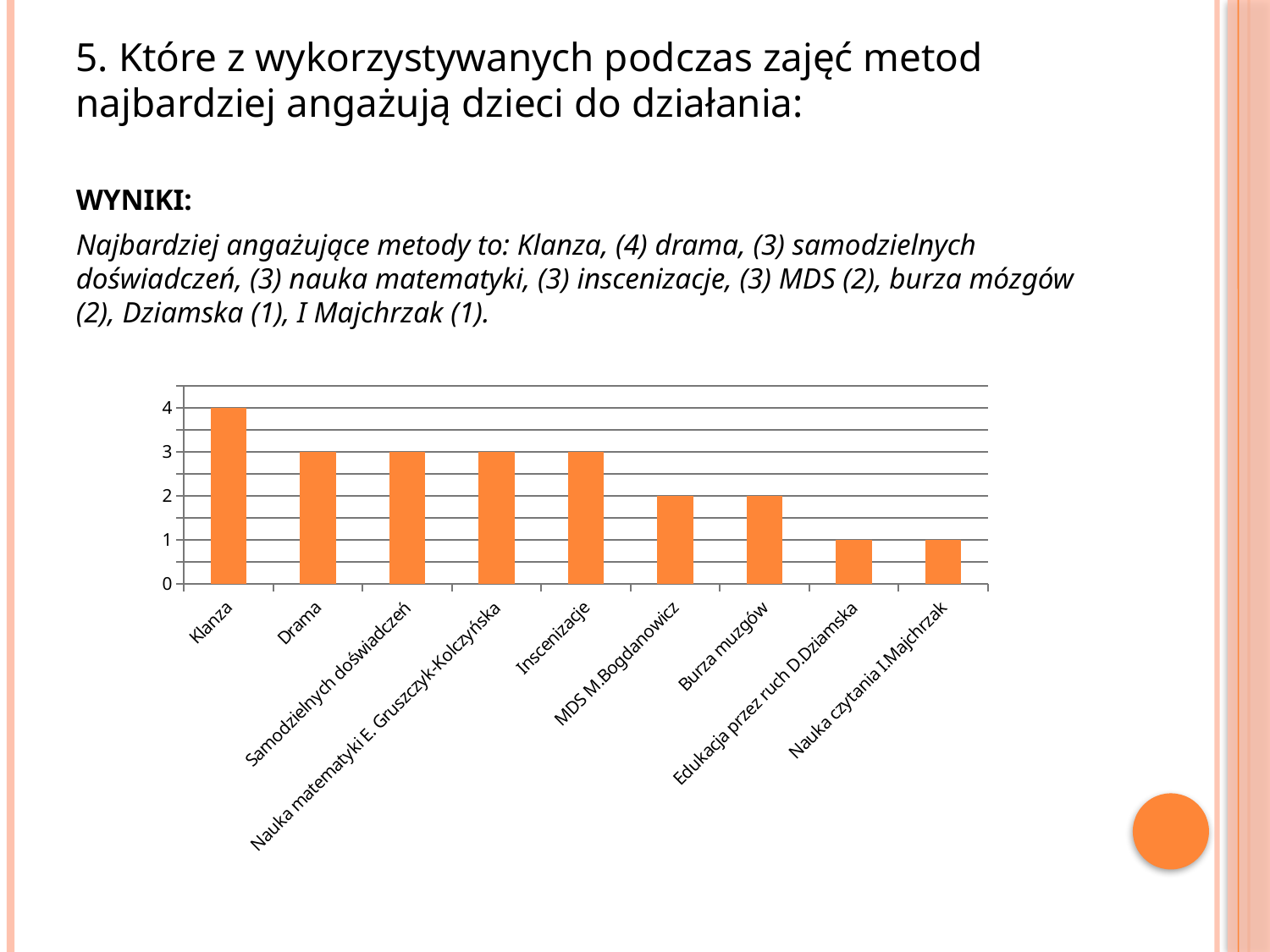
What is the value for Drama? 3 What colour are the bars in the chart? orange What kind of chart is shown on the slide? bar chart Do the values generally rise or fall from left to right along the x axis? fall Which category has the highest value? Klanza What is the difference between the values for Klanza and Burza muzgów? 2 How many categories are shown on the x axis? 9 What is the value for MDS M.Bogdanowicz? 2 Which is larger, the value for Drama or the value for Edukacja przez ruch D.Dziamska? Drama What is the value for Nauka czytania I.Majchrzak? 1 What is the value for Inscenizacje? 3 What is the value for Klanza? 4